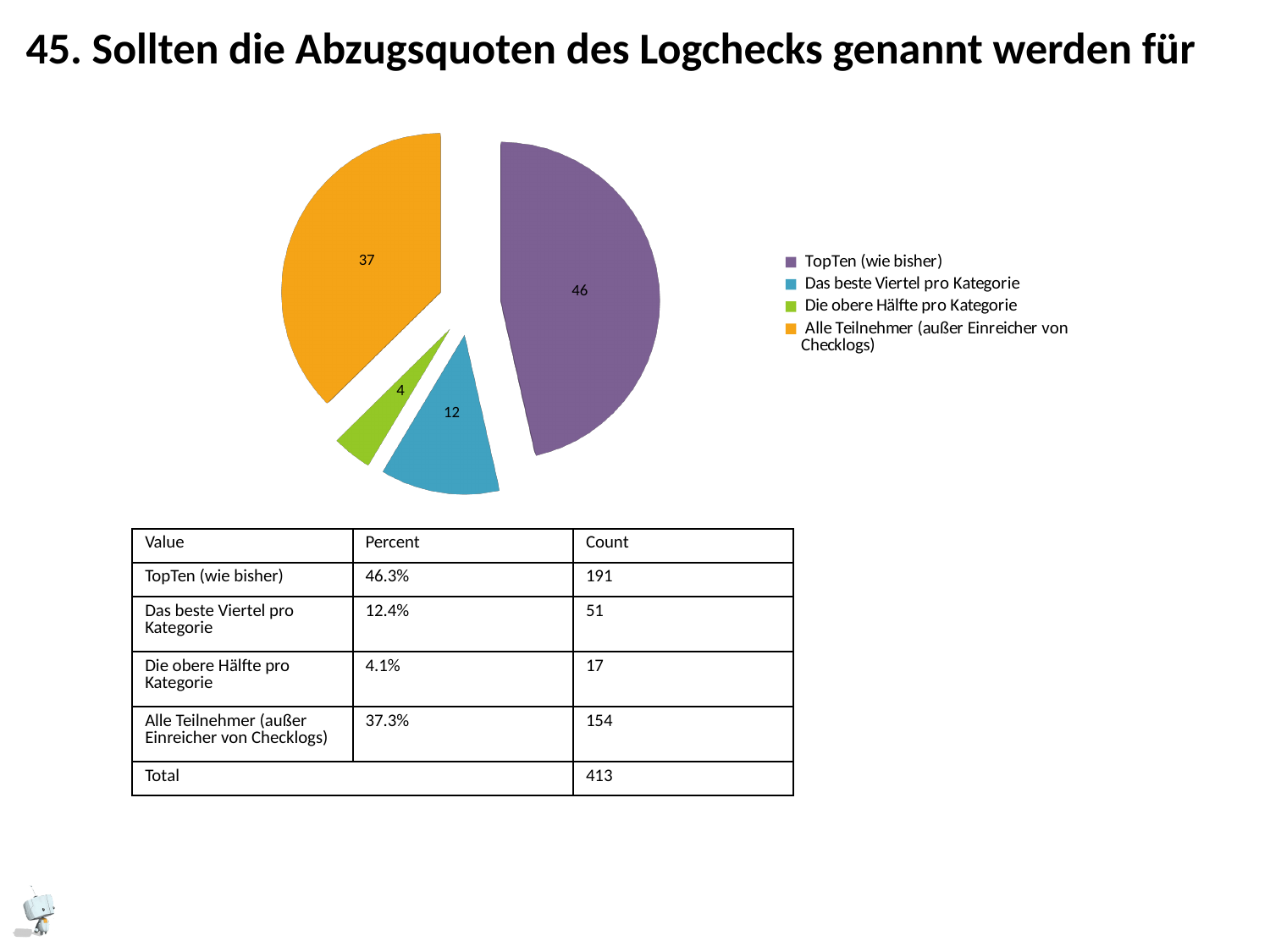
Which category has the largest slice in the pie chart? TopTen (wie bisher) What value is labelled on the pie slice for Das beste Viertel pro Kategorie? 12 How many slices does the pie chart have? 4 What kind of chart is shown on the slide? pie chart What colour is the slice for Alle Teilnehmer (außer Einreicher von Checklogs) in the pie chart? orange What value is labelled on the pie slice for Die obere Hälfte pro Kategorie? 4 What value is labelled on the pie slice for Alle Teilnehmer (außer Einreicher von Checklogs)? 37 What is the difference between the labelled values for TopTen (wie bisher) and Alle Teilnehmer (außer Einreicher von Checklogs)? 9 How many entries does the legend of the pie chart list? 4 Which slice is larger: Das beste Viertel pro Kategorie or Die obere Hälfte pro Kategorie? Das beste Viertel pro Kategorie Which category has the smallest slice in the pie chart? Die obere Hälfte pro Kategorie What value is labelled on the pie slice for TopTen (wie bisher)? 46